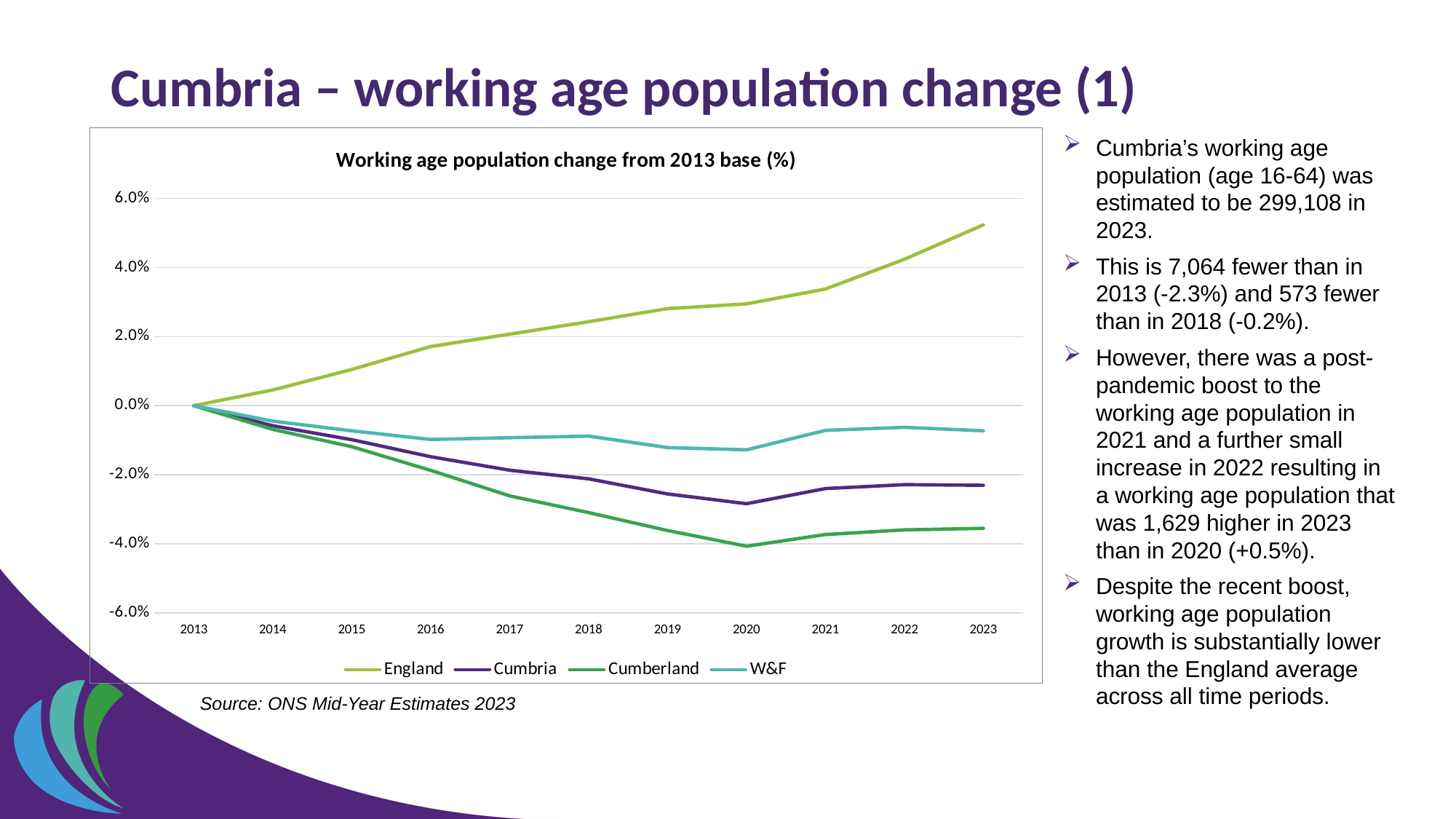
Is the value for W&F in 2023 greater or less than -2.0%? greater What is the value for England in 2013? 0.0% What kind of chart is shown on the slide? line chart In 2020, which is higher, Cumbria or Cumberland? Cumbria How many series does the chart legend list? 4 Is the value for England in 2023 greater or less than 4.0%? greater Is the value for Cumberland in 2020 greater or less than -2.0%? less What is the title of the chart? Working age population change from 2013 base (%) Does the England line rise or fall from 2013 to 2023? rise Which series has the lowest value in 2023? Cumberland Which series has the highest value in 2023? England How many years are plotted along the x axis of the chart? 11